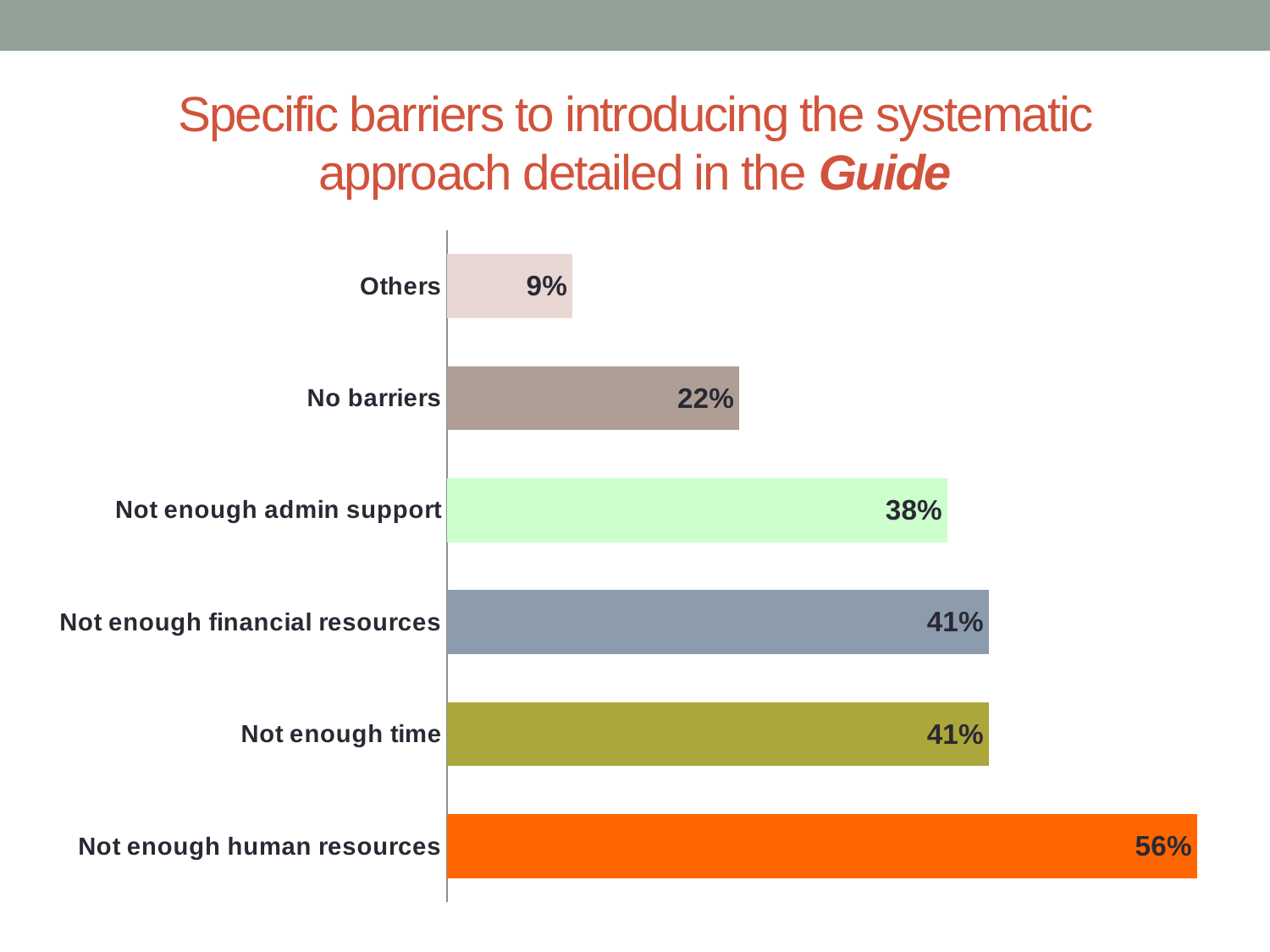
What kind of chart is shown on the slide? Bar chart What is the difference between 'Not enough human resources' and 'Not enough time'? 15% What is the value shown for 'Not enough admin support'? 38% Which barrier has the highest percentage? Not enough human resources What colour is the bar for 'Not enough human resources'? Orange What percentage of respondents cited 'Not enough human resources' as a barrier? 56% Which is larger: 'Not enough admin support' or 'No barriers'? Not enough admin support What percentage reported 'No barriers'? 22% What is the difference between 'No barriers' and 'Others'? 13% What is the value for 'Others'? 9% How many categories are shown in the chart? 6 Which category has the lowest percentage? Others